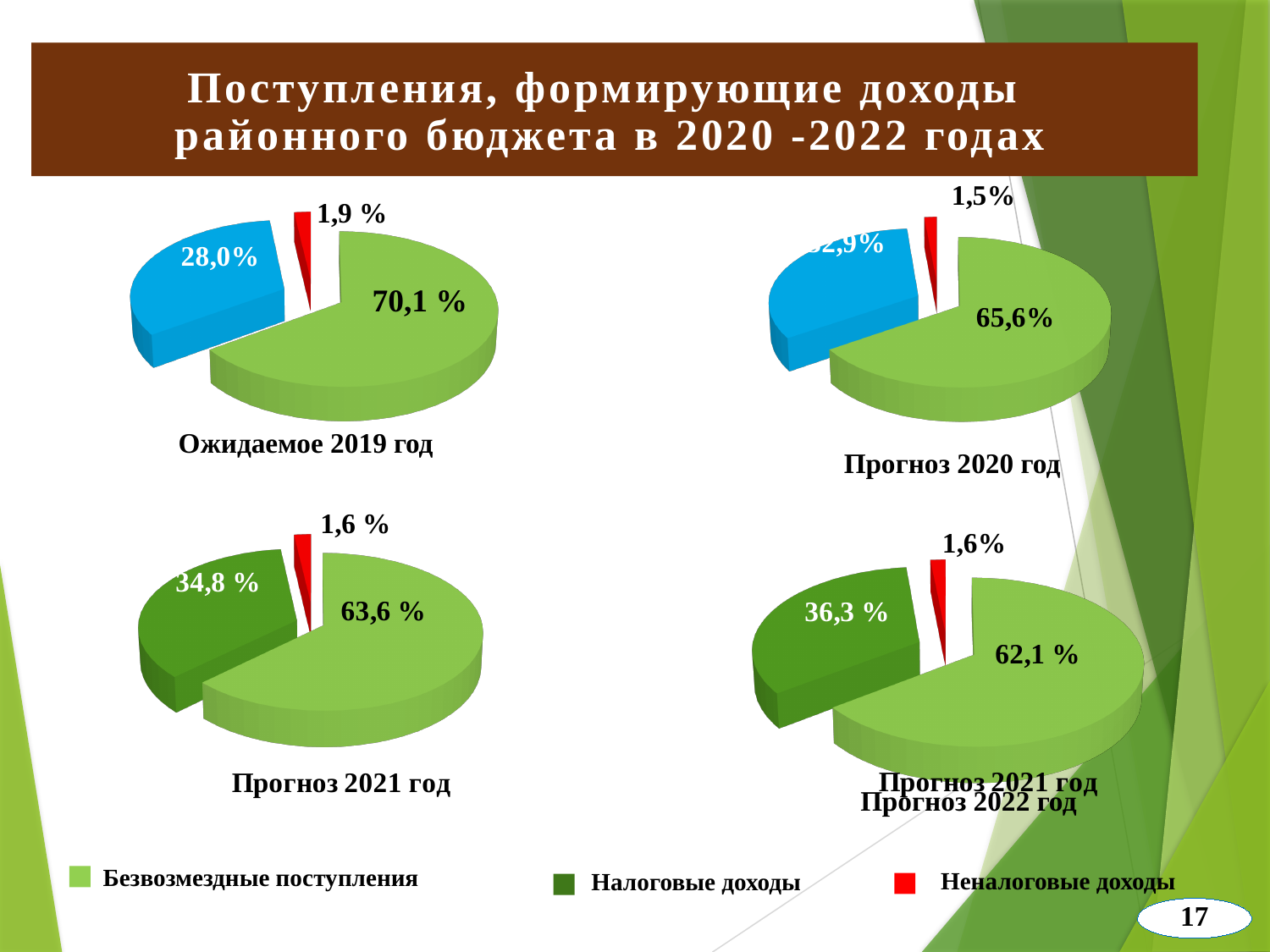
In the chart titled 'Прогноз 2021 год' (bottom-left), what is the difference between the light green slice and the dark green slice? 28,8 % In the chart titled 'Ожидаемое 2019 год', what is the value of the blue slice? 28,0% How many entries does the legend at the bottom of the slide list? 3 In the chart titled 'Ожидаемое 2019 год', what is the value of the largest (light green) slice? 70,1 % In the bottom-right pie chart, what is the value of the light green slice? 62,1 % In the chart titled 'Прогноз 2020 год', what is the value of the red slice? 1,5% In the chart titled 'Ожидаемое 2019 год', what is the value of the red slice? 1,9 % In the chart titled 'Прогноз 2020 год', what is the value of the light green slice? 65,6% In the chart titled 'Прогноз 2021 год' (bottom-left), what is the value of the dark green slice? 34,8 % In the bottom-right pie chart, which slice is the smallest? the red slice (1,6%) What type of chart is used on this slide? pie chart How many pie charts are shown on the slide? 4